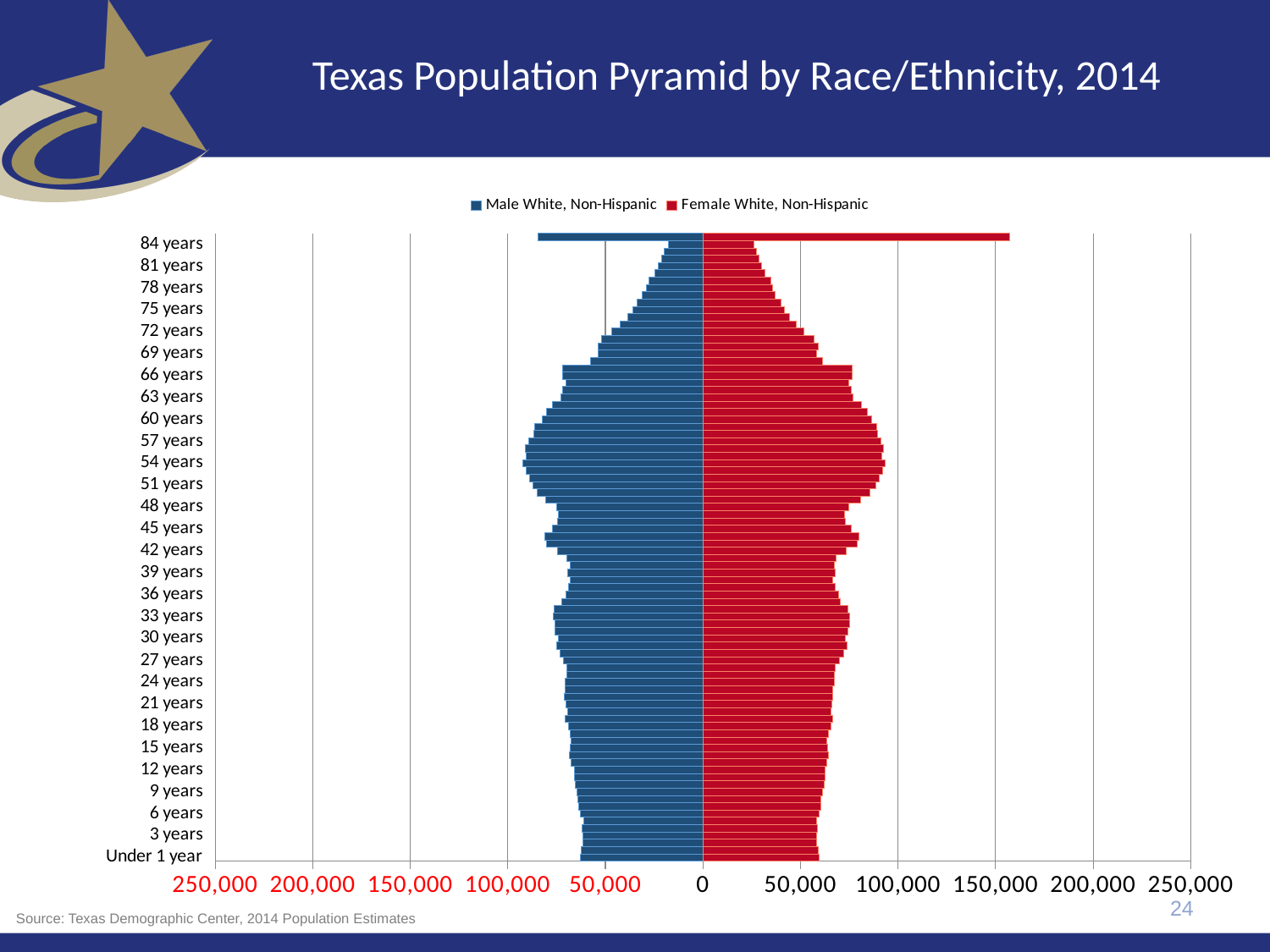
What is the title of the chart? Texas Population Pyramid by Race/Ethnicity, 2014 What kind of chart is shown on the slide? Bar chart How many series does the legend list? 2 Is the value for Female White, Non-Hispanic at 54 years greater or less than 50,000? greater Is the value for Male White, Non-Hispanic at 84 years greater or less than 100,000? less Which series is shown in red? Female White, Non-Hispanic Is the value for Male White, Non-Hispanic at 78 years greater or less than 50,000? less At 84 years, which is larger: the Male White, Non-Hispanic value or the Female White, Non-Hispanic value? Female White, Non-Hispanic